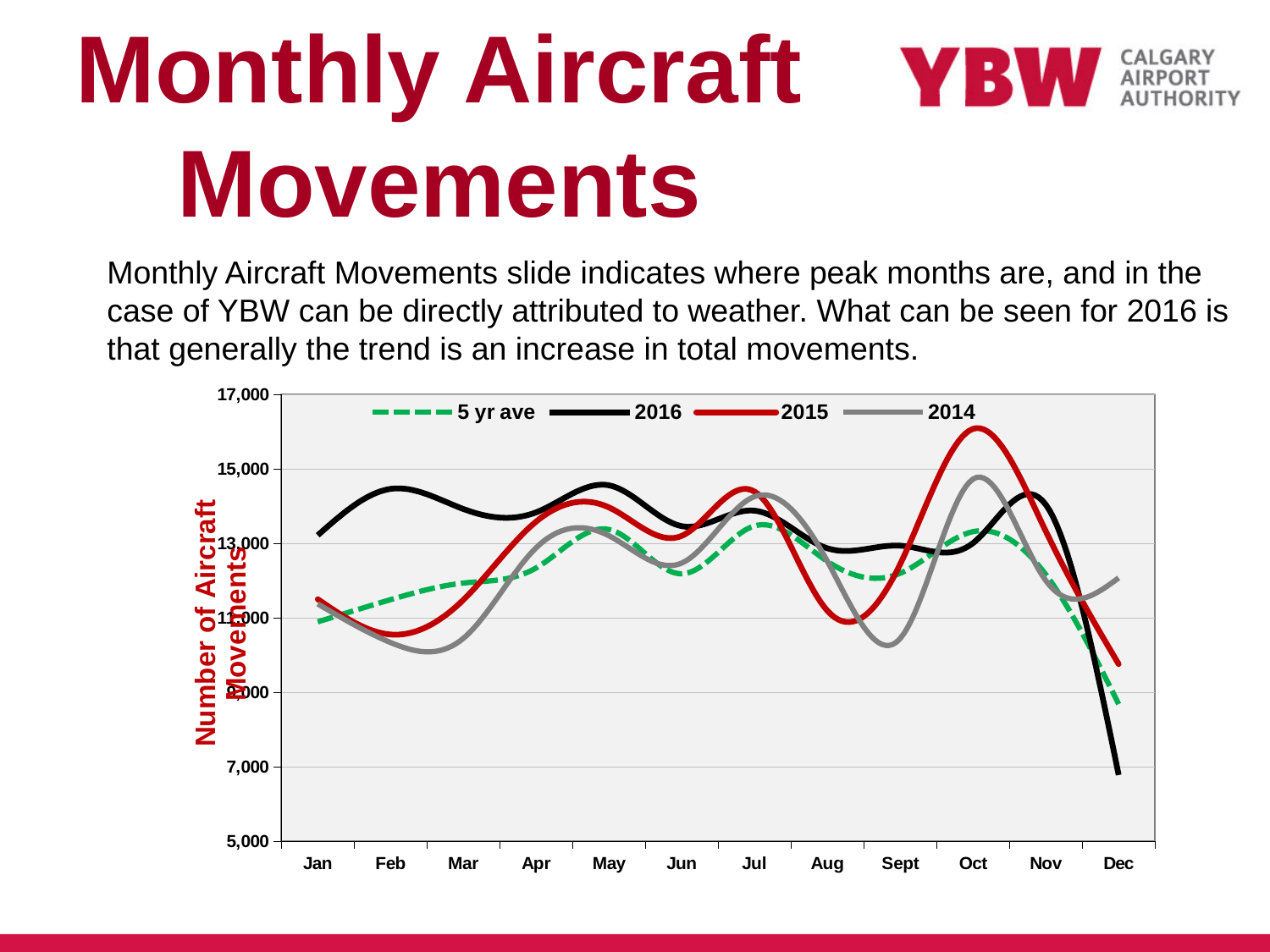
In Oct, which series has the larger value, 2015 or 2016? 2015 How many months are shown along the x axis? 12 How many series does the legend list? 4 In Dec, which series has the larger value, 2014 or 2016? 2014 Is the value for 2016 in Feb greater or less than 13,000? greater Is the value for 2015 in Oct greater or less than 15,000? greater Which series is drawn with a dashed line? 5 yr ave Does the 2016 series rise or fall from Nov to Dec? fall In which month does the 2016 series reach its lowest value? Dec Is the value for 2014 in Feb greater or less than 11,000? less In which month does the 2015 series reach its highest value? Oct What kind of chart is shown on the slide? line chart